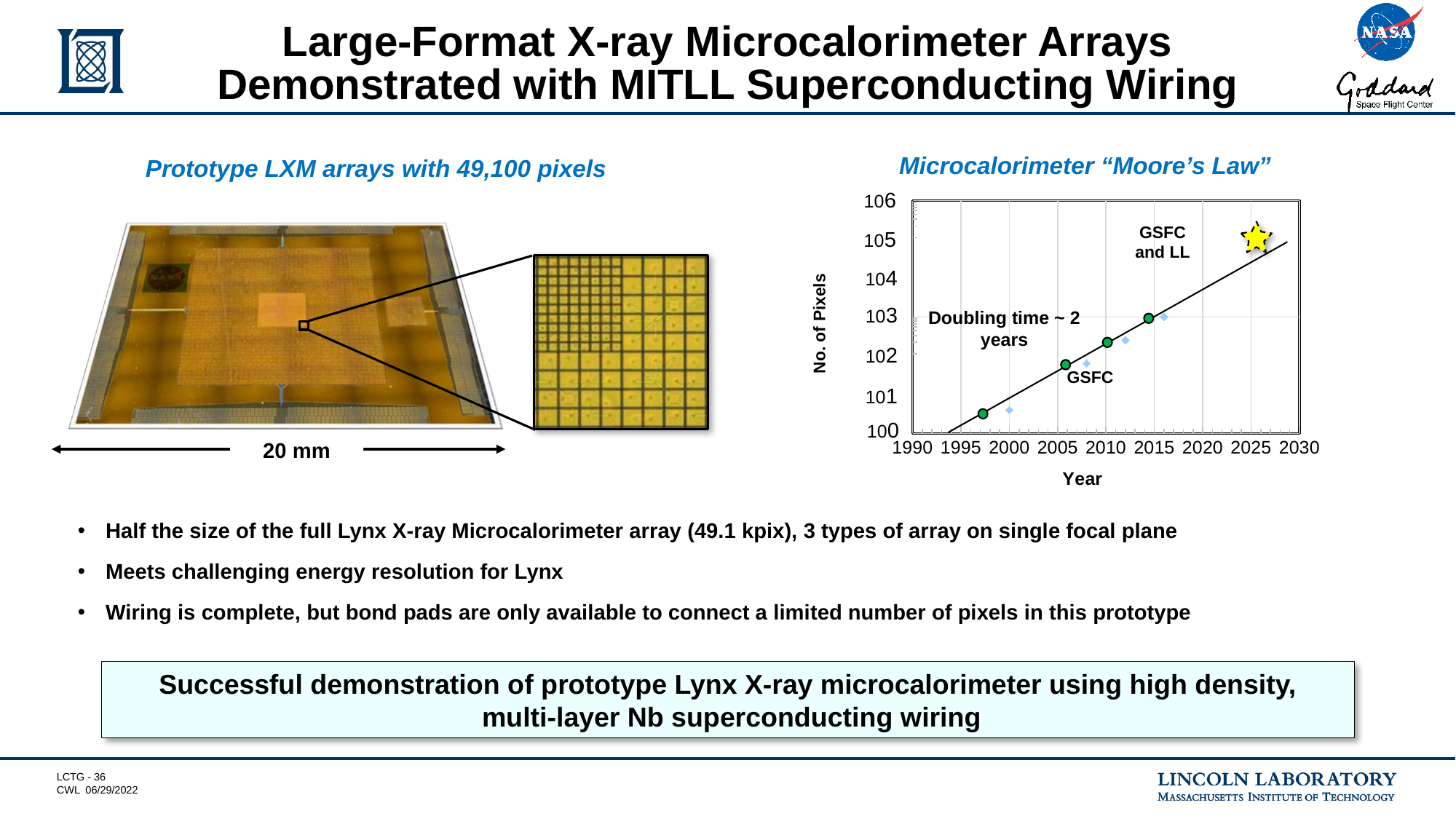
On the Microcalorimeter "Moore's Law" chart, is the number of pixels for the green point around 2014 greater or less than 10^2? greater What is the title of the chart on the right side of the slide? Microcalorimeter "Moore's Law" On the Microcalorimeter "Moore's Law" chart, which plotted point has the highest number of pixels? The star point (GSFC and LL, around 2026) On the Microcalorimeter "Moore's Law" chart, which has more pixels: the green point around 2006 or the green point around 2014? The point around 2014 On the Microcalorimeter "Moore's Law" chart, what is the first year shown on the x-axis? 1990 On the Microcalorimeter "Moore's Law" chart, does the number of pixels rise or fall as the year increases? Rise On the Microcalorimeter "Moore's Law" chart, what doubling time is annotated for the number of pixels? ~ 2 years On the Microcalorimeter "Moore's Law" chart, is the number of pixels for the earliest green point (around 1997) greater or less than 10^1? less What is the label of the y-axis on the Microcalorimeter "Moore's Law" chart? No. of Pixels What kind of chart is the "Microcalorimeter "Moore's Law"" chart? Scatter chart with a trend line On the Microcalorimeter "Moore's Law" chart, is the number of pixels for the star point near 2026 greater or less than 10^4? greater On the Microcalorimeter "Moore's Law" chart, what is the highest value shown on the y-axis? 10^6